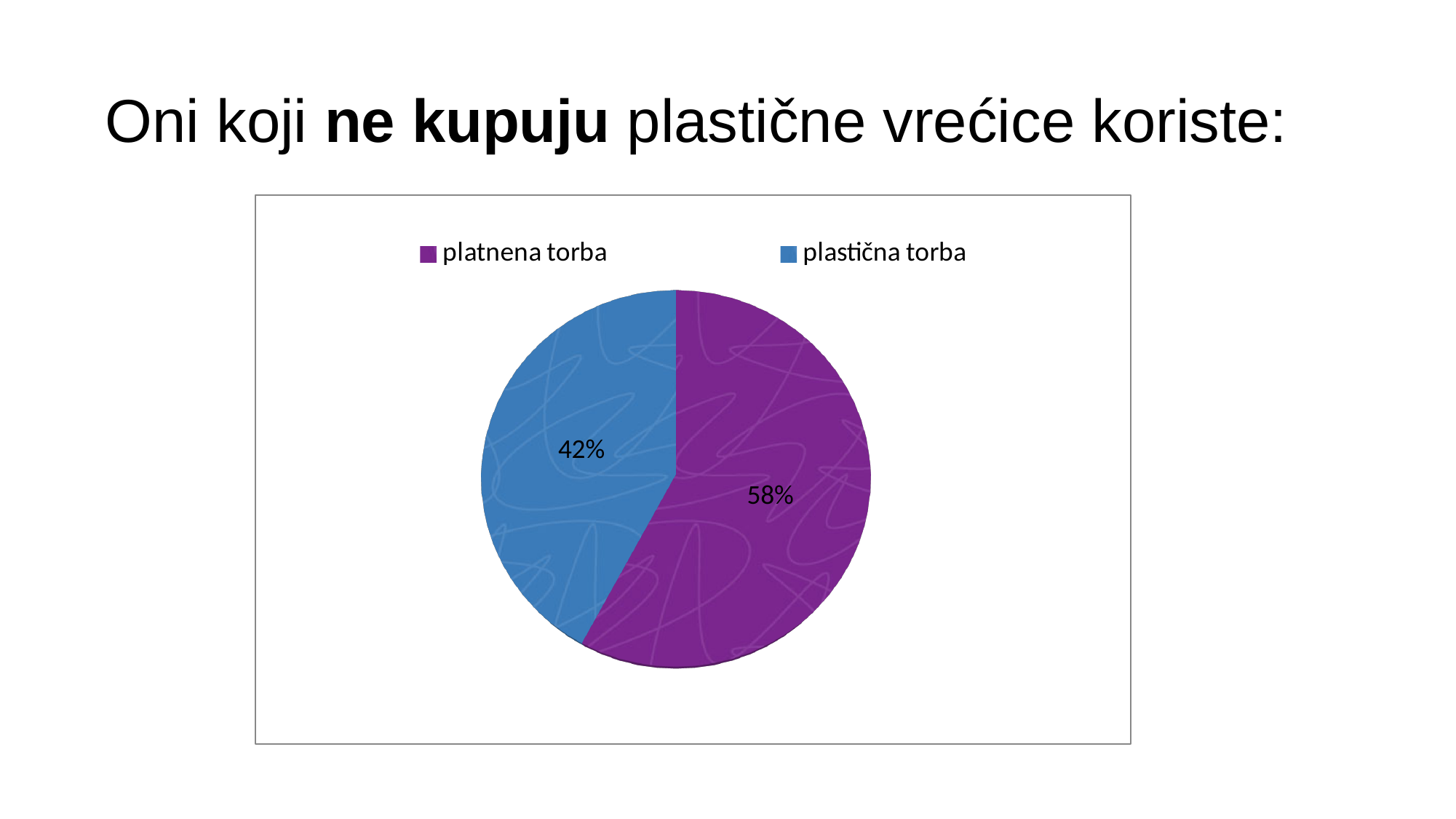
What colour is the "plastična torba" slice? blue How many slices does the pie chart have? 2 Is the share for "platnena torba" greater or less than 50%? greater How many entries does the legend list? 2 Which category has the smallest slice of the pie? plastična torba What share of the pie does "plastična torba" have? 42% Which category has the largest slice of the pie? platnena torba What is the difference in percentage points between the "platnena torba" and "plastična torba" slices? 16% What kind of chart is shown on the slide? pie chart What colour is the "platnena torba" slice? purple Which slice is larger, "platnena torba" or "plastična torba"? platnena torba What share of the pie does "platnena torba" have? 58%